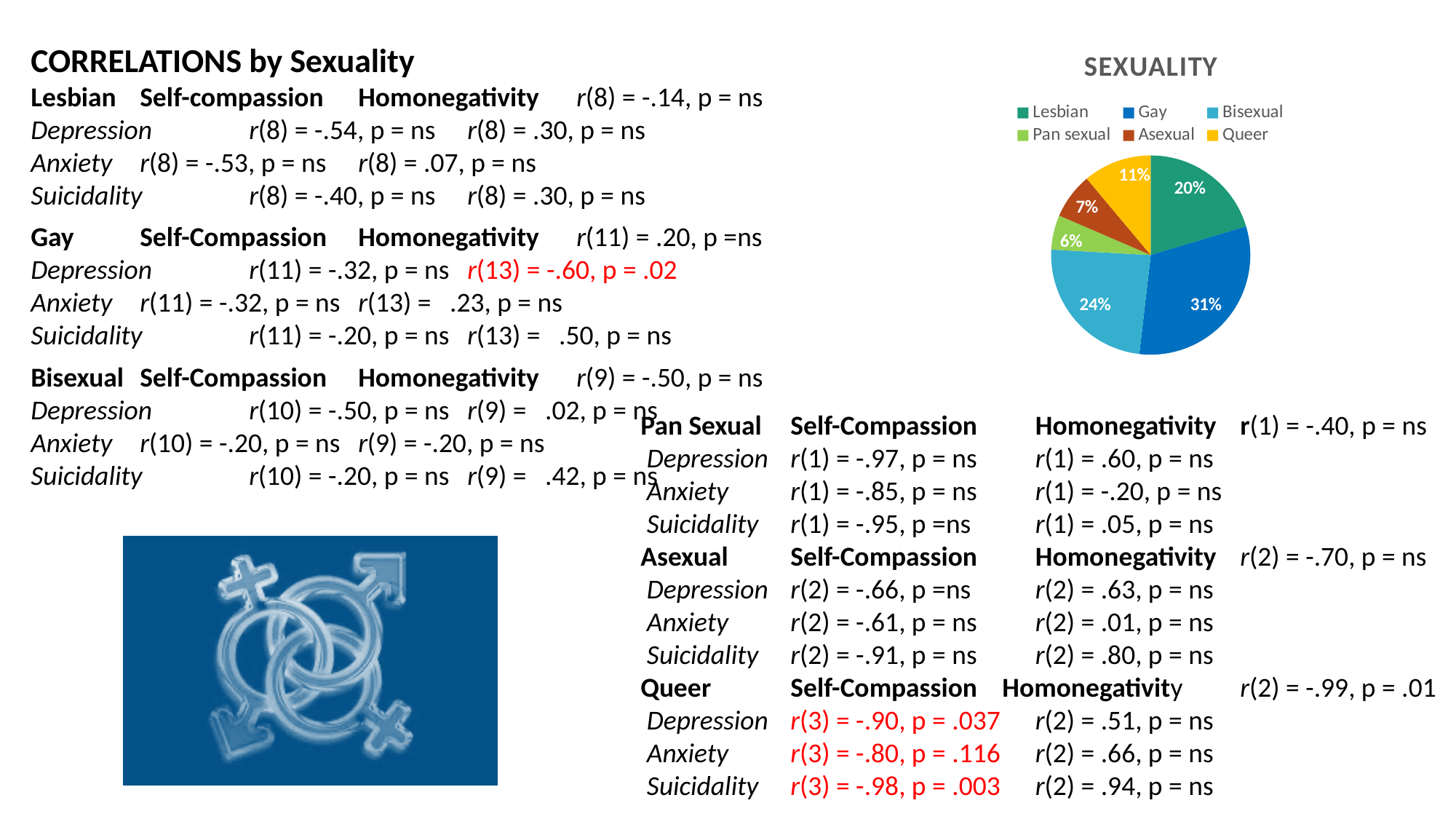
Which category has the smallest share of the pie chart? Pan sexual What percentage of the pie chart is Asexual? 7% Which slice is larger, Lesbian or Queer? Lesbian How many categories does the pie chart legend list? 6 What percentage of the pie chart is Lesbian? 20% What percentage of the pie chart is Bisexual? 24% Which category has the largest share of the pie chart? Gay What percentage of the pie chart is Queer? 11% What percentage of the pie chart is Gay? 31% What is the title of the pie chart? SEXUALITY What is the difference in percentage points between the Gay and Bisexual slices? 7 What type of chart is shown on the slide? pie chart